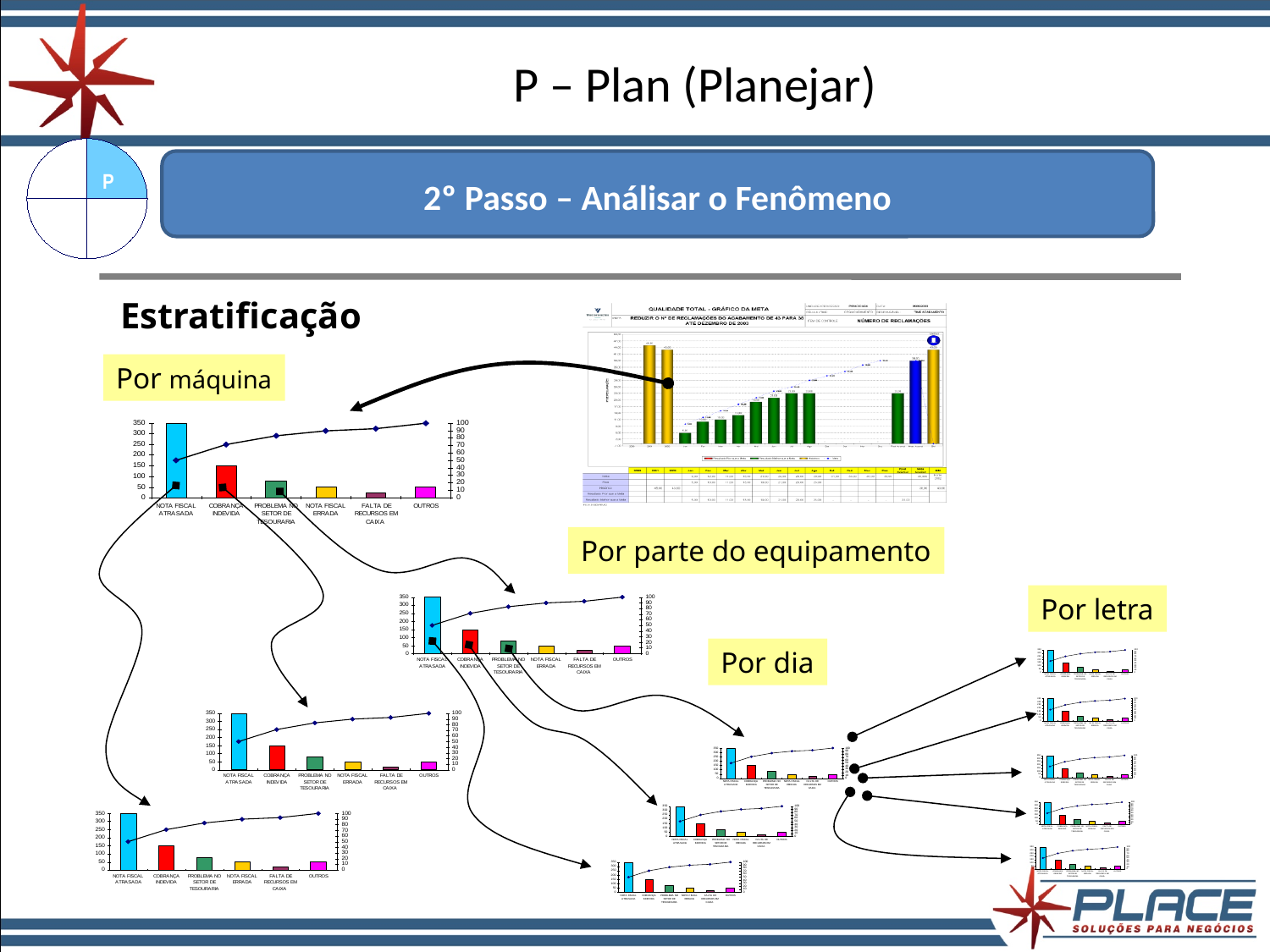
On the 'Por máquina' chart at the top left, what kind of chart is it? bar chart What is the title of the chart at the top right of the slide? QUALIDADE TOTAL - GRÁFICO DA META On the 'Por máquina' chart at the top left, how many categories are shown on the x axis? 6 On the 'Por máquina' chart at the top left, is the bar for FALTA DE RECURSOS EM CAIXA greater or less than 50? less On the 'Por máquina' chart at the top left, is the bar for NOTA FISCAL ATRASADA greater or less than 300? greater On the 'Por máquina' chart at the top left, which category has the tallest bar? NOTA FISCAL ATRASADA On the 'Por máquina' chart at the top left, what is the highest tick value on the left vertical axis? 350 On the 'Por máquina' chart at the top left, does the cumulative line rise or fall from left to right? rise On the 'Por máquina' chart at the top left, which bar is taller: COBRANÇA INDEVIDA or PROBLEMA NO SETOR DE TESOURARIA? COBRANÇA INDEVIDA On the 'Por máquina' chart at the top left, which category has the shortest bar? FALTA DE RECURSOS EM CAIXA On the 'Por máquina' chart at the top left, is the bar for COBRANÇA INDEVIDA greater or less than 100? greater